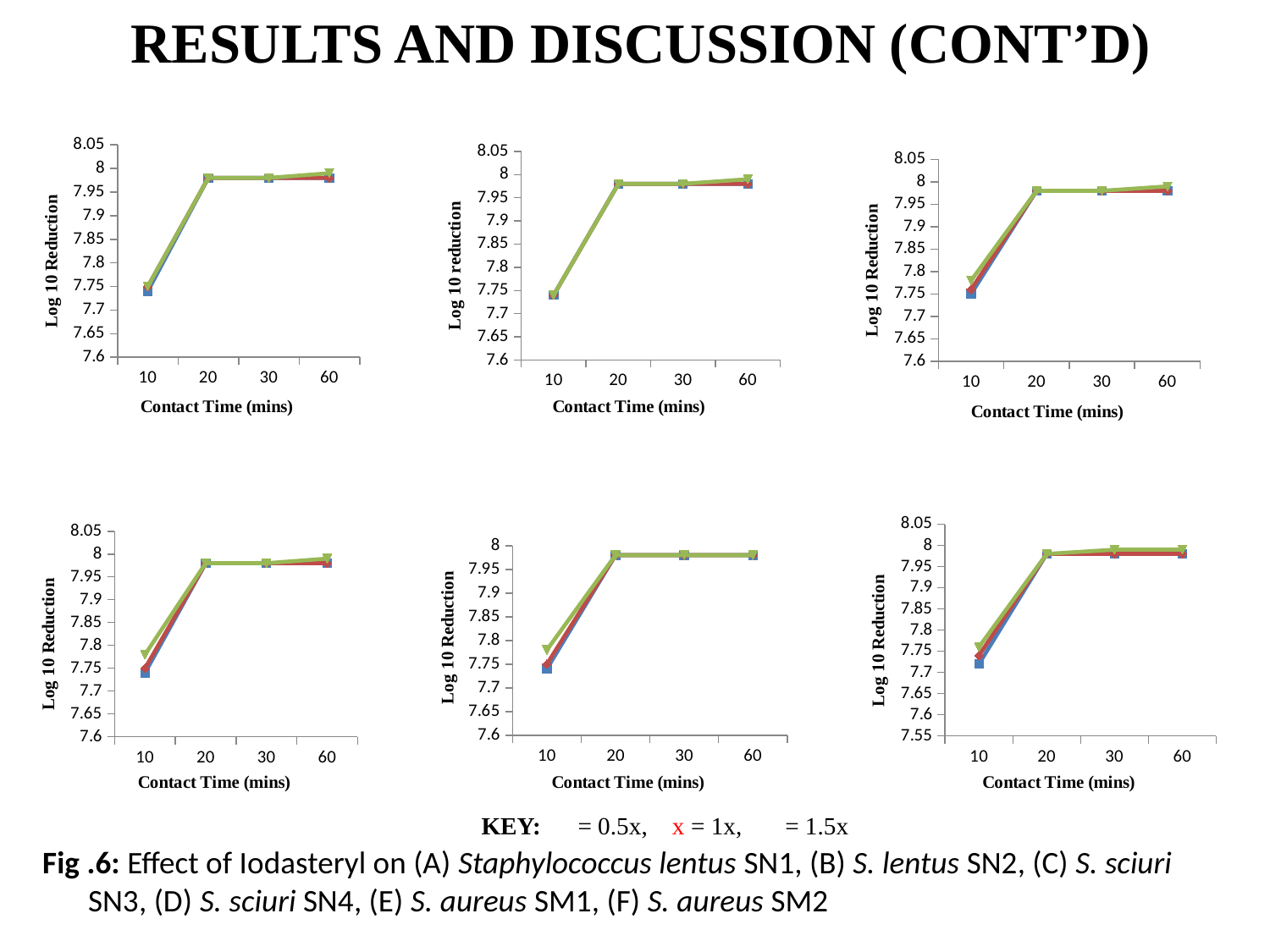
In the bottom-middle chart, is the value at 10 mins contact time greater or less than 7.85? less What is the y-axis title of the top-right chart? Log 10 Reduction How many series does the key at the bottom of the slide list? 3 How many contact-time points are plotted along the x axis of the top-left chart? 4 In the top-left chart, is the value at 10 mins contact time greater or less than 7.8? less What kind of chart is the top-left chart on the slide? line chart In the top-right chart, which contact time has the lowest Log 10 Reduction? 10 In the top-left chart, is the value at 20 mins contact time greater or less than 7.9? greater In the top-middle chart, do the values rise or fall from 10 mins to 20 mins of contact time? rise In the bottom-left chart, which is larger, the value at 10 mins or the value at 30 mins? 30 mins What is the x-axis title of the bottom-left chart? Contact Time (mins)